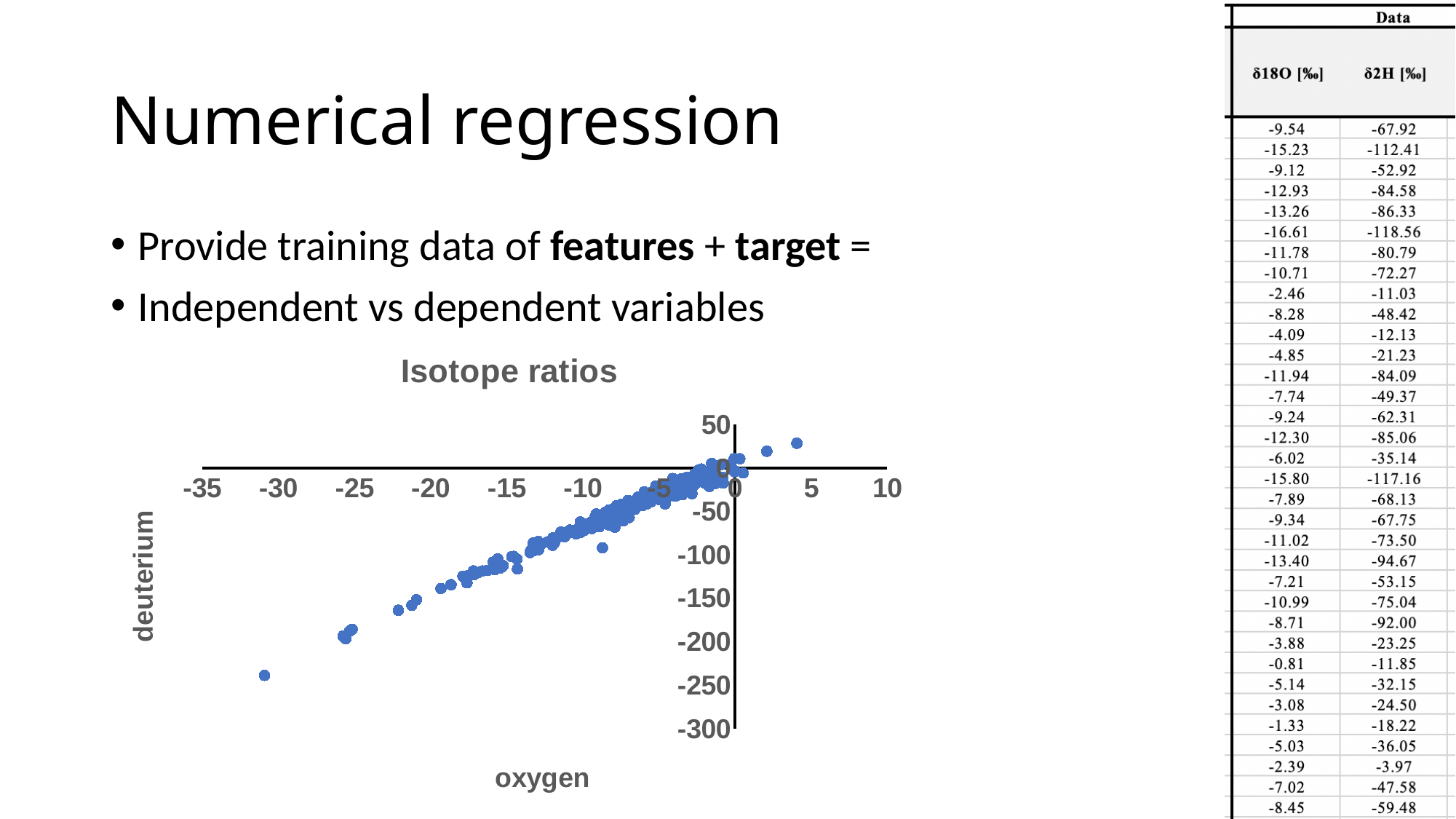
Is the deuterium value of the point with the lowest oxygen value greater or less than -300? greater As oxygen increases along the x axis, do the deuterium values rise or fall? rise What is the title of the chart? Isotope ratios What is the highest value shown on the x axis of the chart? 10 What kind of chart is shown on the slide? scatter chart Are the deuterium values of the points with oxygen near -25 greater or less than -150? less What is the label of the x axis of the chart? oxygen What is the lowest value shown on the y axis of the chart? -300 Is the oxygen value of the leftmost point greater or less than -25? less Which has the lower deuterium value: the leftmost point or the rightmost point? the leftmost point